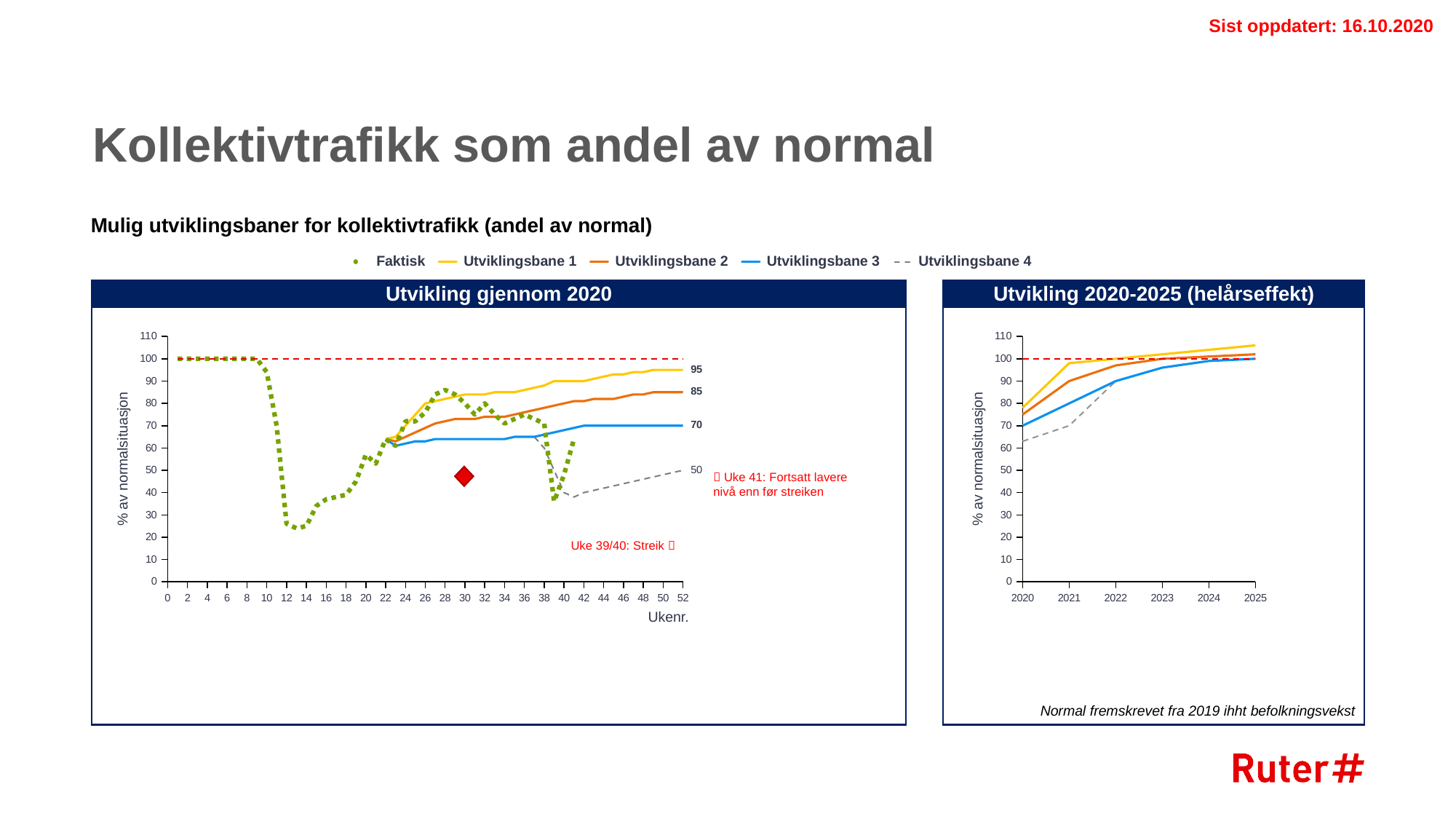
What is the y-axis label of the chart 'Utvikling 2020-2025 (helårseffekt)'? % av normalsituasjon In the chart 'Utvikling gjennom 2020', which Utviklingsbane ends highest at week 52? Utviklingsbane 1 In the chart 'Utvikling 2020-2025 (helårseffekt)', is the value for Utviklingsbane 4 in 2020 greater or less than 70? less What kind of chart is 'Utvikling gjennom 2020'? line chart In the chart 'Utvikling gjennom 2020', is the Faktisk value at week 13 greater or less than 30? less In the chart 'Utvikling gjennom 2020', which Utviklingsbane ends lowest at week 52? Utviklingsbane 4 In the chart 'Utvikling gjennom 2020', which is larger at week 52: Utviklingsbane 2 or Utviklingsbane 3? Utviklingsbane 2 In the chart 'Utvikling gjennom 2020', what value does Utviklingsbane 4 reach at week 52? 50 In the chart 'Utvikling gjennom 2020', what value does Utviklingsbane 1 reach at week 52? 95 How many series does the shared legend above the charts list? 5 In the chart 'Utvikling 2020-2025 (helårseffekt)', how many years are shown on the x axis? 6 In the chart 'Utvikling gjennom 2020', what is the difference between the week-52 values of Utviklingsbane 1 and Utviklingsbane 3? 25